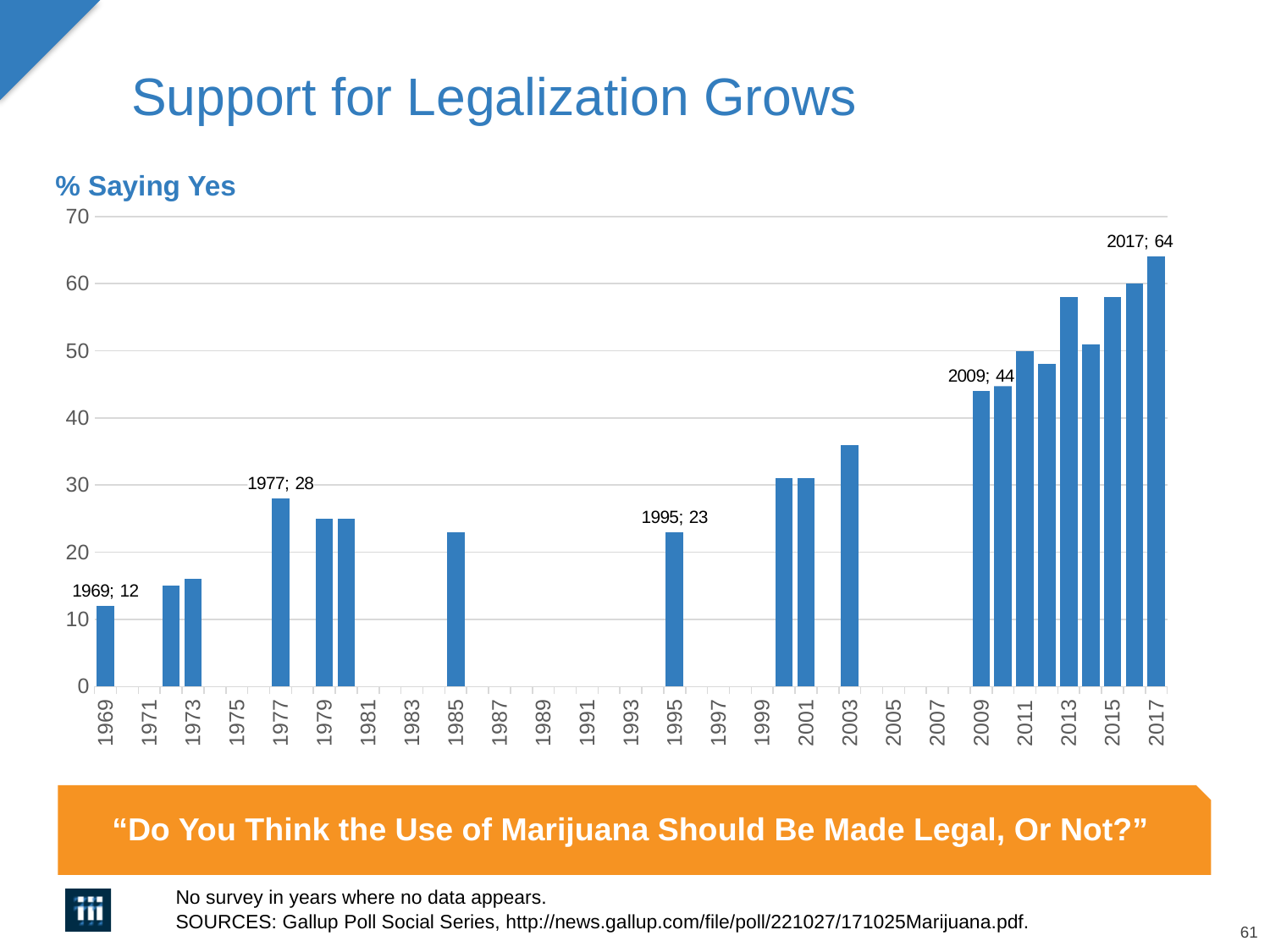
What percentage said yes in 2017? 64 Is the value for 2003 greater or less than 30? greater What percentage said yes in 1969? 12 Which is larger, the value for 1977 or the value for 1995? 1977 Which year has the lowest percentage saying yes? 1969 Which year has the highest percentage saying yes? 2017 What value is shown for 1977? 28 What value is shown for 2009? 44 What percentage said yes in 1995? 23 Do the values generally rise or fall from 1969 to 2017? rise What kind of chart is shown on the slide? bar chart How much higher is the 2017 value than the 1969 value? 52